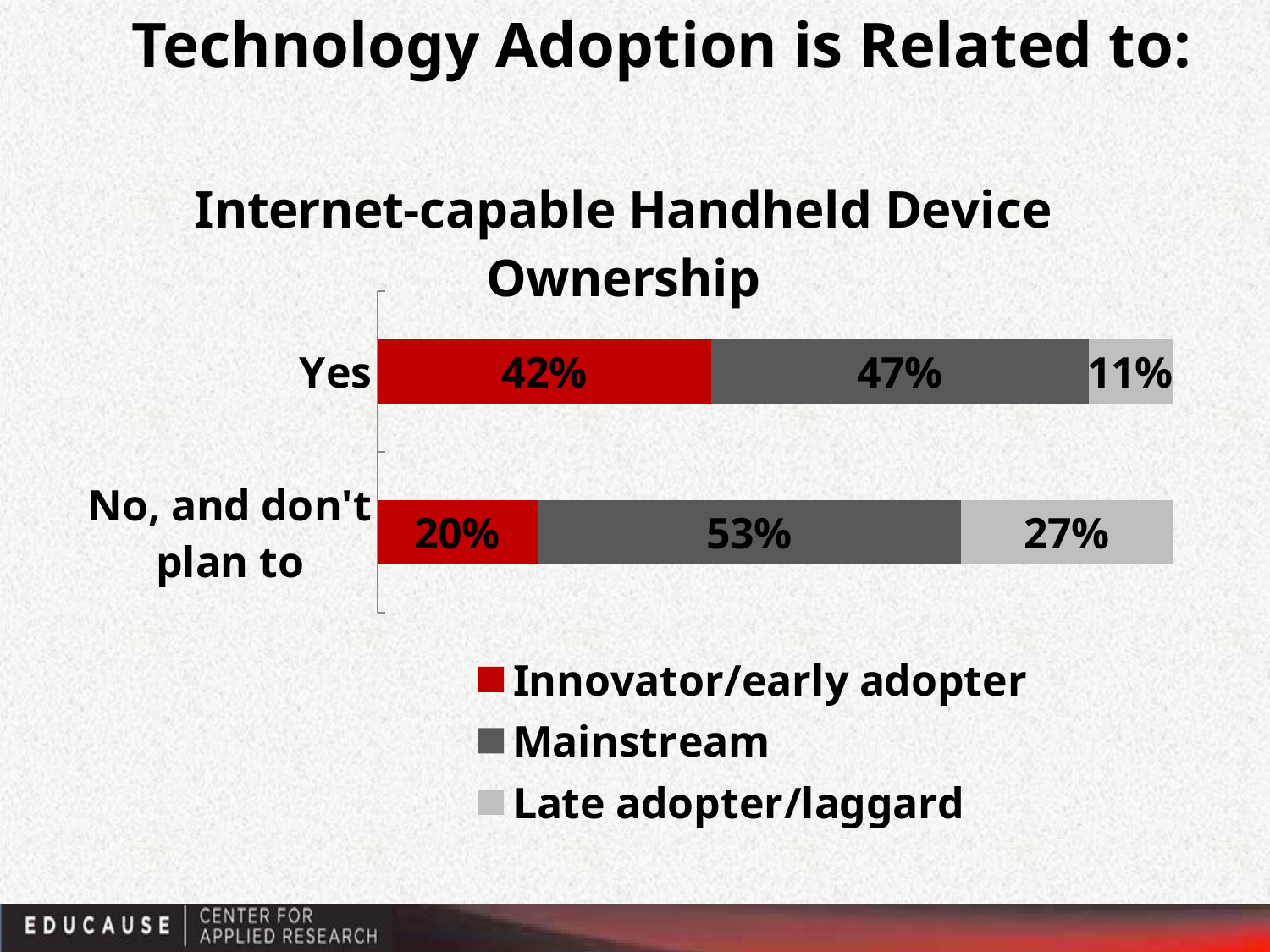
What is the title of the chart? Internet-capable Handheld Device Ownership What is the Late adopter/laggard value for "Yes"? 11% Is the Mainstream value larger for "Yes" or for "No, and don't plan to"? No, and don't plan to What percentage of the "Yes" bar is Innovator/early adopter? 42% Which category has the higher Late adopter/laggard share? No, and don't plan to What kind of chart is shown? Stacked bar chart What is the Innovator/early adopter value for "No, and don't plan to"? 20% How many series does the legend list? 3 What is the difference between the Innovator/early adopter values for "Yes" and "No, and don't plan to"? 22 percentage points Which category has the lower Innovator/early adopter share? No, and don't plan to How many categories are shown on the chart? 2 What is the Mainstream value for "No, and don't plan to"? 53%